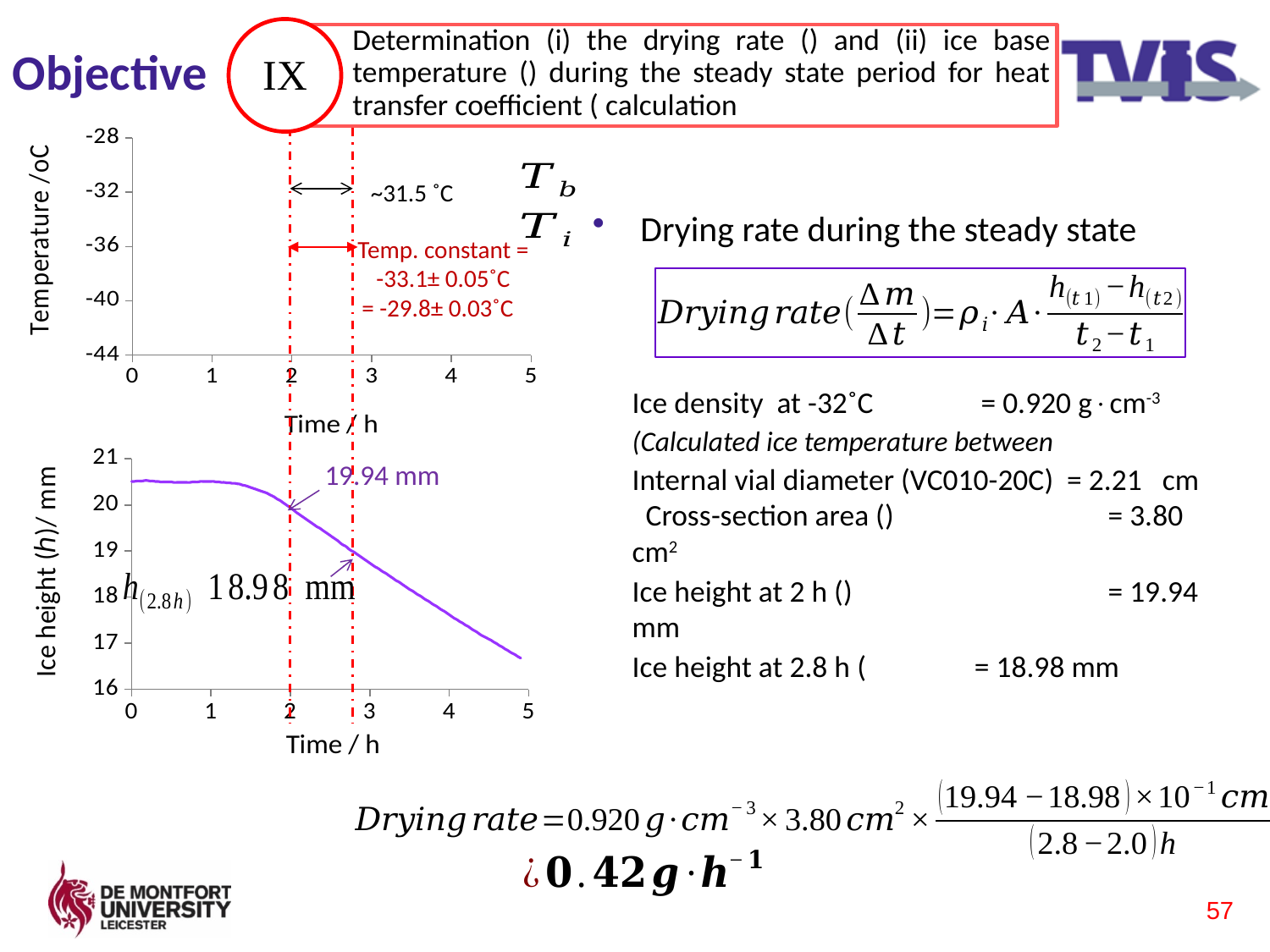
In the bottom chart (Ice height vs Time), is the ice height at 3.5 h greater or less than 19? less How many lines are plotted in the bottom chart (Ice height vs Time)? 1 In the bottom chart (Ice height vs Time), does the ice height rise or fall as time increases? fall In the bottom chart (Ice height vs Time), is the ice height at 1 h greater or less than 20? greater In the bottom chart (Ice height vs Time), is the ice height at 4 h greater or less than 18? less What is the y-axis label of the top chart? Temperature /oC In the bottom chart (Ice height vs Time), what is the ice height at 2.8 h? 18.98 mm In the bottom chart (Ice height vs Time), what is the difference between the ice height at 2 h and at 2.8 h? 0.96 mm What is the x-axis label of the bottom chart (Ice height vs Time)? Time / h In the bottom chart (Ice height vs Time), what is the ice height at 2 h? 19.94 mm In the bottom chart (Ice height vs Time), which is larger: the ice height at 2 h or at 2.8 h? 2 h What kind of chart is the bottom chart (Ice height vs Time)? line chart